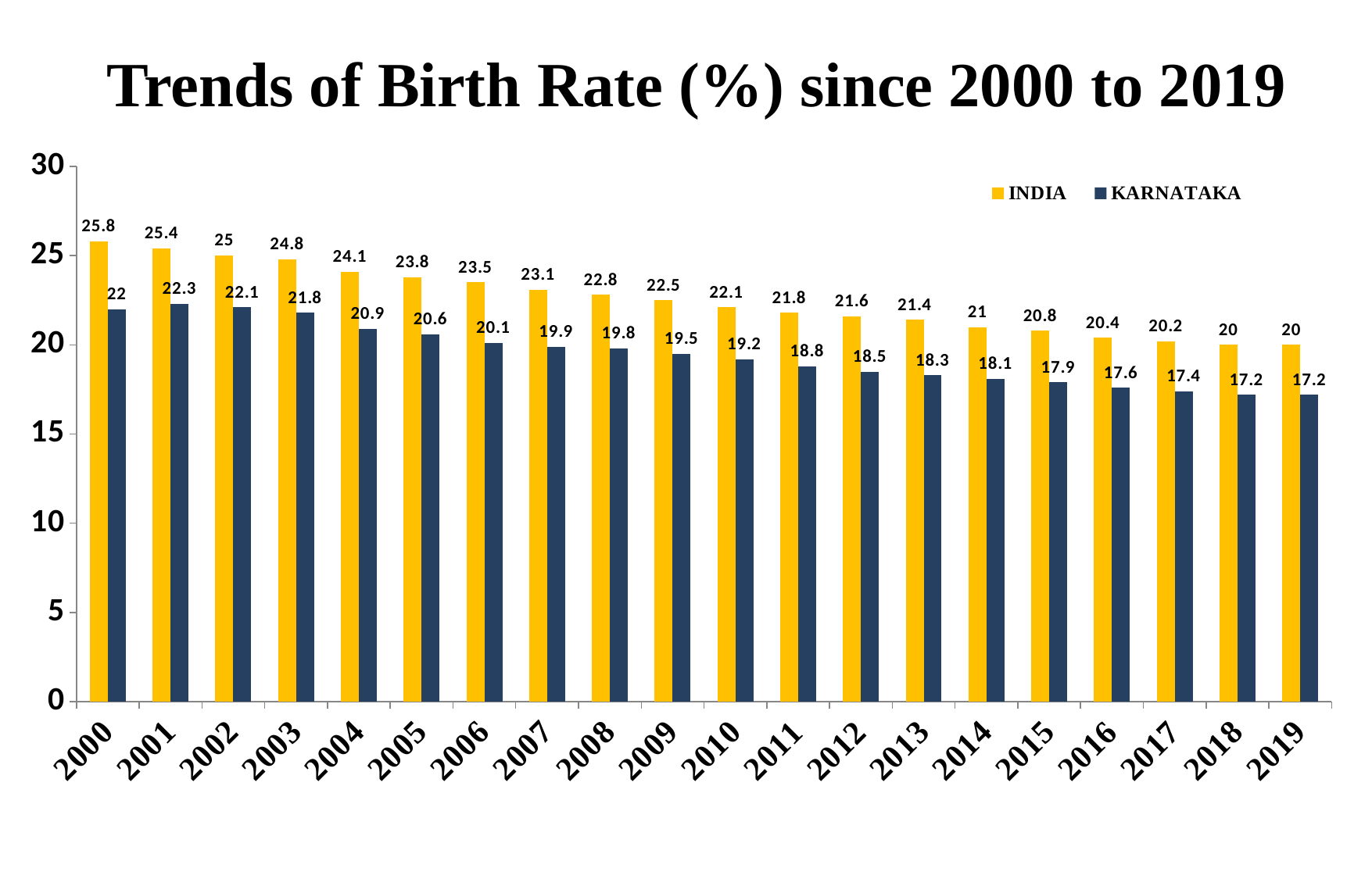
What is the difference between the INDIA and KARNATAKA birth rates in 2005? 3.2 How many series does the legend list? 2 In which year is the INDIA birth rate highest? 2000 What is the birth rate for INDIA in 2000? 25.8 What kind of chart is shown on the slide? bar chart What is the birth rate for KARNATAKA in 2019? 17.2 What is the birth rate for KARNATAKA in 2010? 19.2 How many years are shown on the x axis? 20 Which is larger in 2012, the INDIA birth rate or the KARNATAKA birth rate? INDIA In which year is the KARNATAKA birth rate lowest? 2018 and 2019 Is the KARNATAKA birth rate in 2015 greater or less than 20? less Do the INDIA birth rate values rise or fall from 2000 to 2019? fall